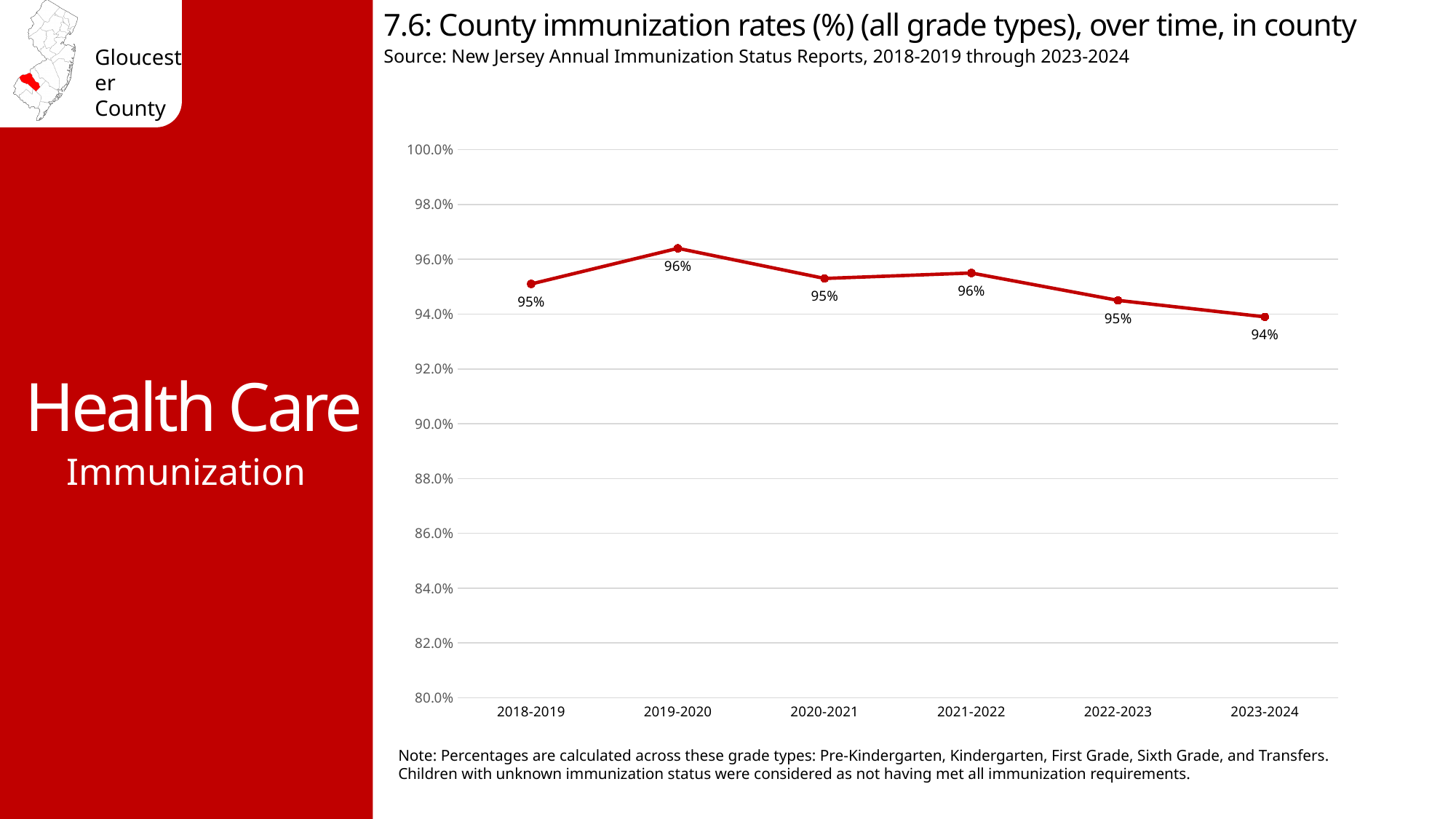
What is the difference between the labelled immunization rates for 2019-2020 and 2023-2024? 2 percentage points How many school years are plotted on the chart? 6 Is the immunization rate for 2022-2023 greater or less than 94.0%? greater Which school year has the highest immunization rate? 2019-2020 What is the county immunization rate for 2019-2020? 96% What is the county immunization rate for 2022-2023? 95% What is the county immunization rate for 2018-2019? 95% Which is larger, the immunization rate for 2018-2019 or for 2023-2024? 2018-2019 Which school year has the lowest immunization rate? 2023-2024 Does the immunization rate rise or fall from 2021-2022 to 2023-2024? Fall What is the county immunization rate for 2023-2024? 94% What type of chart is shown on the slide? Line chart